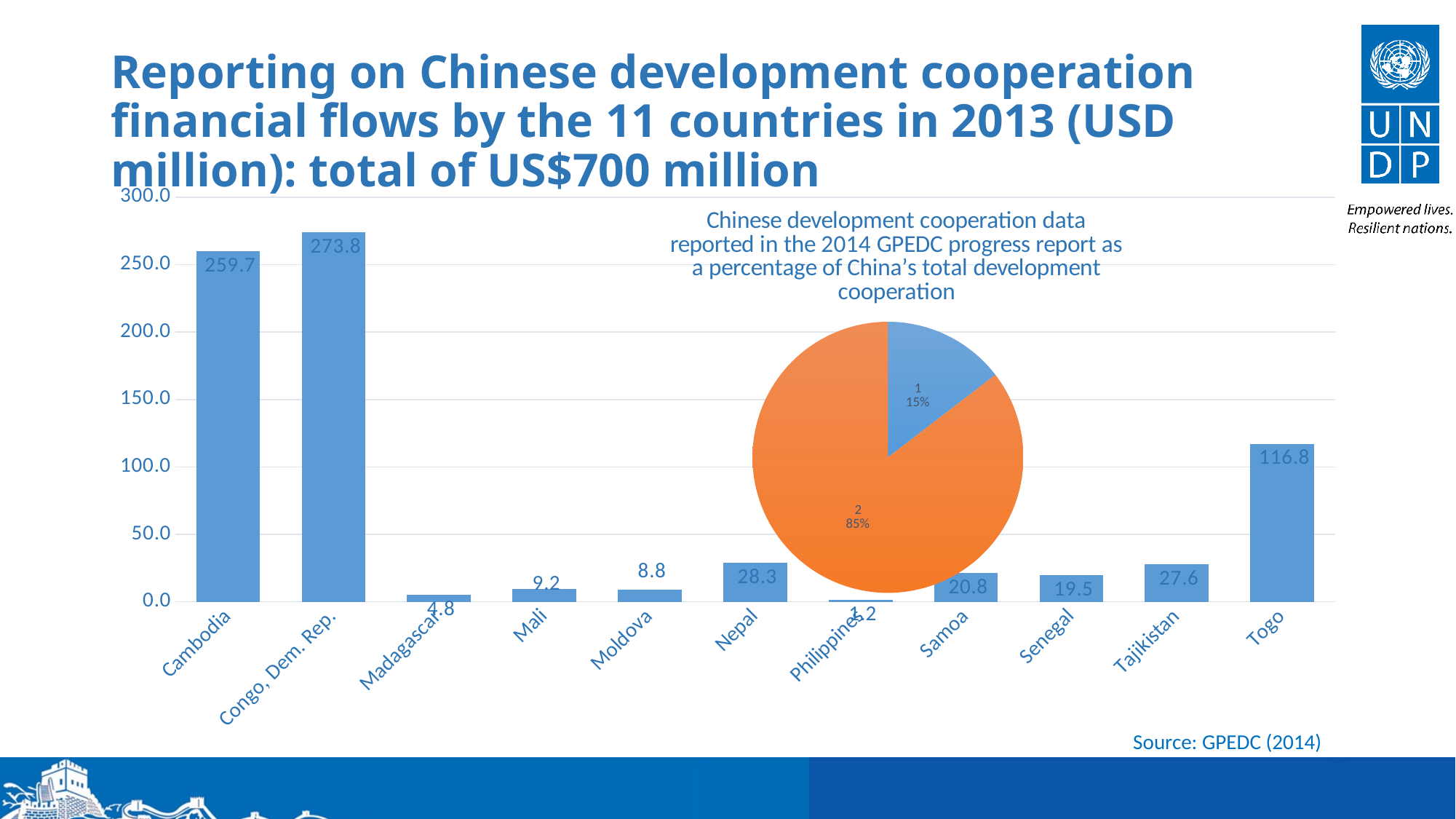
In the bar chart, what is the value for Nepal? 28.3 What kind of chart shows the values by country? bar chart In the bar chart, what is the value for Congo, Dem. Rep.? 273.8 In the bar chart, which is larger, the value for Samoa or the value for Senegal? Samoa In the pie chart, what share does slice 1 have? 15% In the bar chart, is the value for Togo greater or less than 100.0? greater In the bar chart, which country has the highest value? Congo, Dem. Rep. In the pie chart, what share does slice 2 have? 85% In the bar chart, what is the difference between the values for Congo, Dem. Rep. and Cambodia? 14.1 What is the title of the pie chart? Chinese development cooperation data reported in the 2014 GPEDC progress report as a percentage of China's total development cooperation How many countries are shown in the bar chart? 11 In the bar chart, what is the value for Togo? 116.8